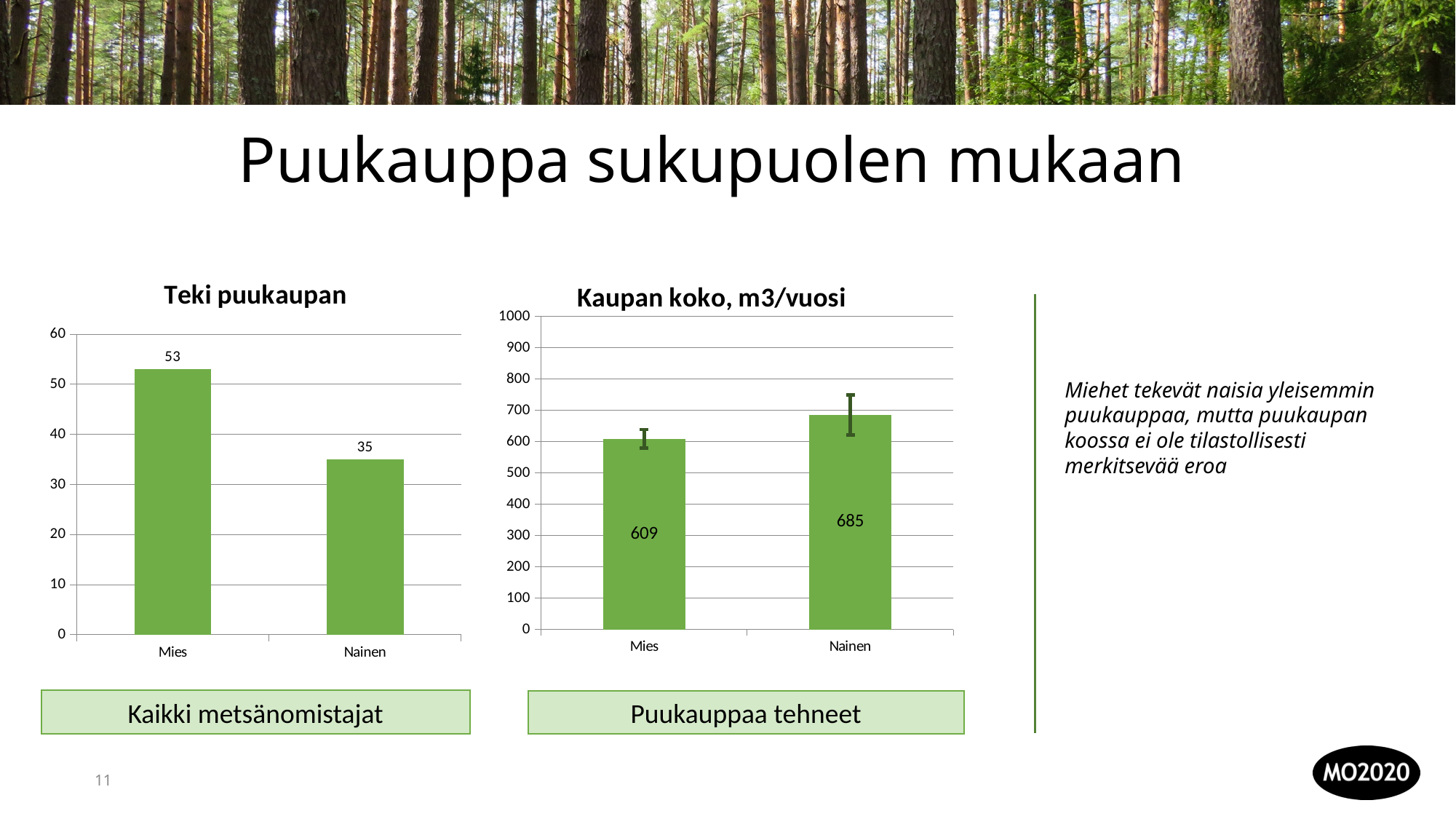
In the 'Kaupan koko, m3/vuosi' chart, what is the value for Mies? 609 In the 'Kaupan koko, m3/vuosi' chart, which category has the lowest value? Mies How many categories are shown in the 'Teki puukaupan' chart? 2 In the 'Kaupan koko, m3/vuosi' chart, which is larger, the value for Mies or for Nainen? Nainen What is the title of the chart on the left side of the slide? Teki puukaupan In the 'Teki puukaupan' chart, what is the value for Mies? 53 In the 'Teki puukaupan' chart, which category has the highest value? Mies In the 'Kaupan koko, m3/vuosi' chart, what is the difference between the values for Nainen and Mies? 76 In the 'Teki puukaupan' chart, what is the difference between the values for Mies and Nainen? 18 In the 'Teki puukaupan' chart, what is the value for Nainen? 35 In the 'Kaupan koko, m3/vuosi' chart, what is the value for Nainen? 685 What kind of chart is the 'Kaupan koko, m3/vuosi' chart? Bar chart